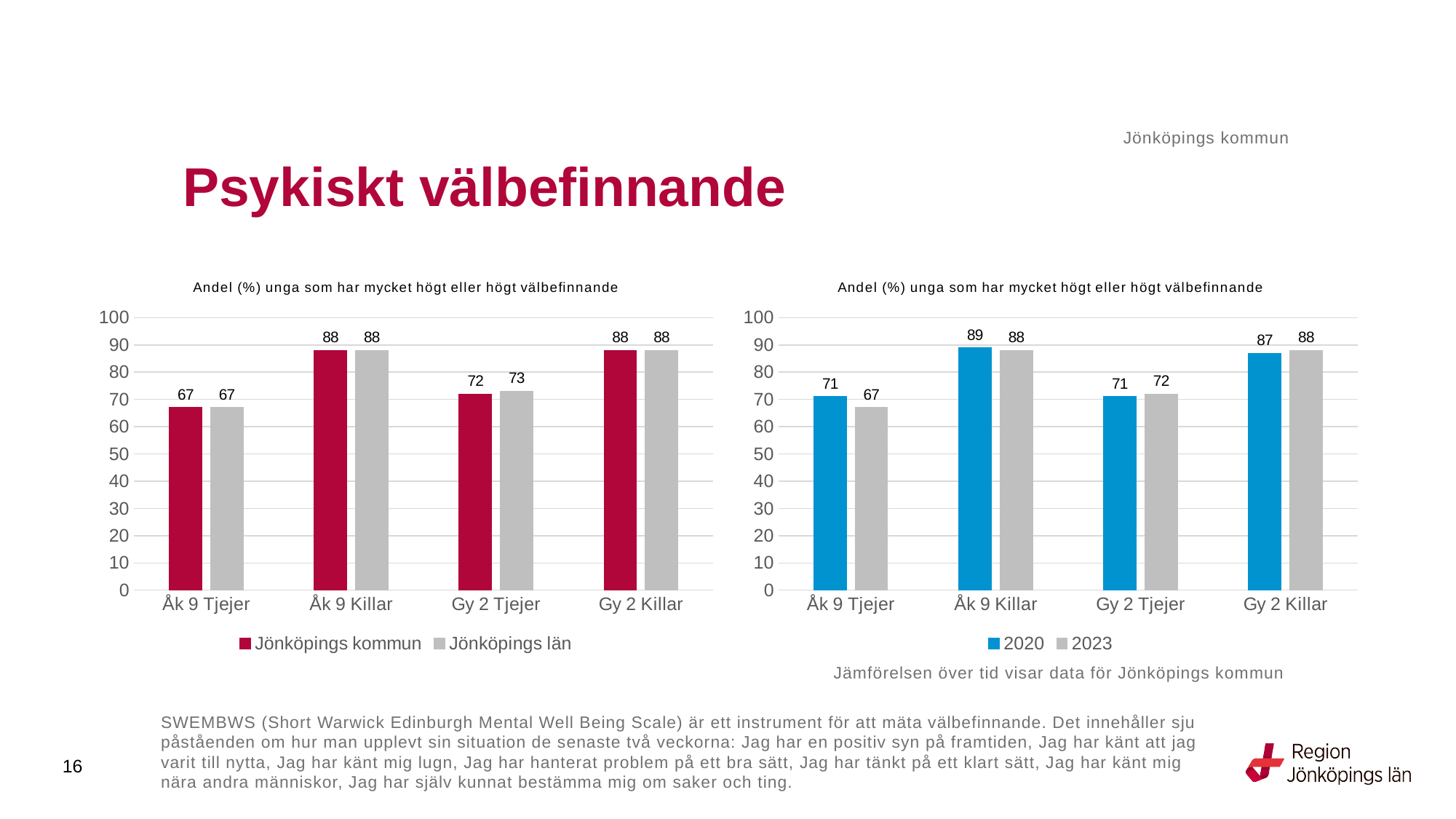
In the left chart, what is the value for Jönköpings län for Åk 9 Tjejer? 67 What kind of chart is the left chart? Bar chart In the right chart, what is the 2020 value for Åk 9 Killar? 89 In the right chart, which category has the lowest 2023 value? Åk 9 Tjejer In the left chart, what is the difference between the Jönköpings län value for Åk 9 Killar and for Gy 2 Tjejer? 15 In the right chart, what is the difference between the 2020 and 2023 values for Åk 9 Tjejer? 4 In the left chart, what is the value for Jönköpings kommun for Gy 2 Tjejer? 72 In the right chart, which is larger for Åk 9 Tjejer: the 2020 value or the 2023 value? 2020 In the right chart, what is the 2023 value for Gy 2 Killar? 88 How many categories are shown on the x axis of the left chart? 4 How many series does the legend of the right chart list? 2 In the left chart, which category has the lowest Jönköpings kommun value? Åk 9 Tjejer